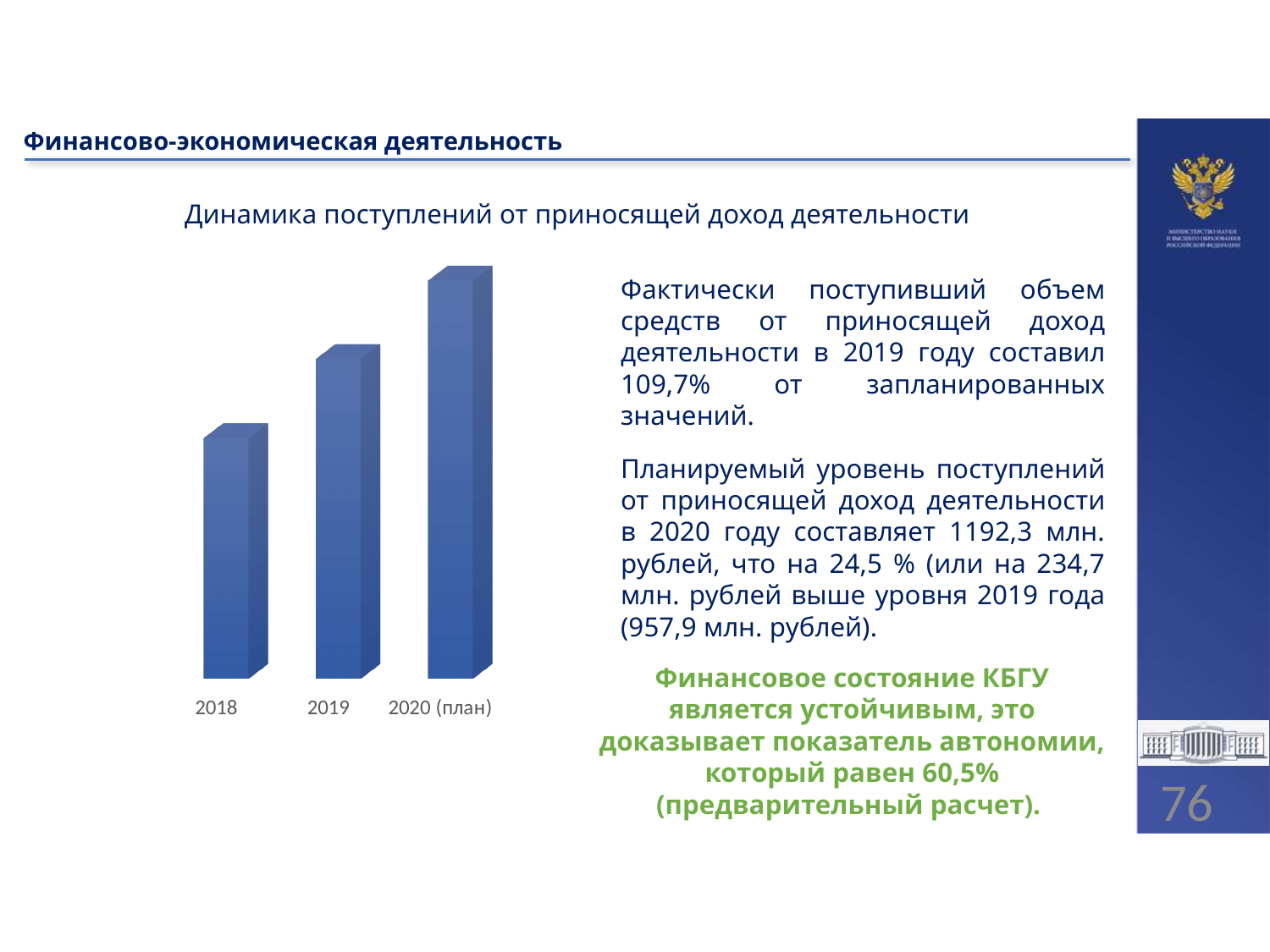
What is the title of the chart? Динамика поступлений от приносящей доход деятельности Do the bar values rise or fall from 2018 to 2020 (план)? rise What kind of chart is shown on the slide? bar chart Which category has the highest bar? 2020 (план) Which bar is taller, 2019 or 2020 (план)? 2020 (план) Which bar is taller, 2018 or 2019? 2019 How many bars (categories) does the chart show? 3 Which category has the lowest bar? 2018 What is the label of the last category on the x axis? 2020 (план)